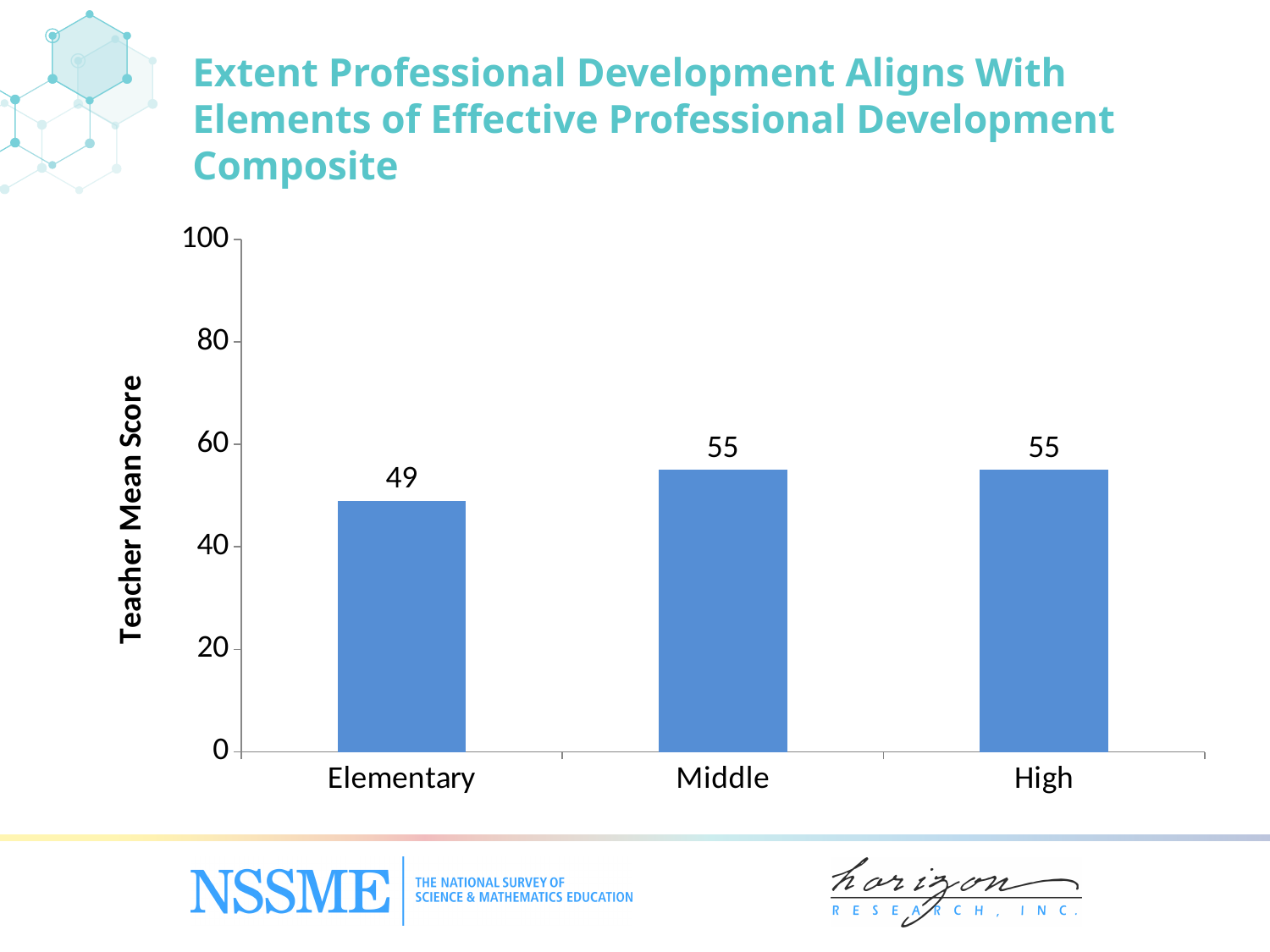
What is the teacher mean score for High? 55 What is the maximum value shown on the vertical axis? 100 What is the teacher mean score for Middle? 55 Is the teacher mean score for Middle greater or less than 40? greater How many grade-level categories are shown on the chart? 3 What kind of chart is shown on the slide? bar chart Is the teacher mean score for Elementary greater or less than 60? less Which grade level has the lowest teacher mean score? Elementary What is the difference between the teacher mean scores for Middle and Elementary? 6 What is the teacher mean score for Elementary? 49 Which is larger, the teacher mean score for Elementary or for High? High What is the label of the vertical axis? Teacher Mean Score